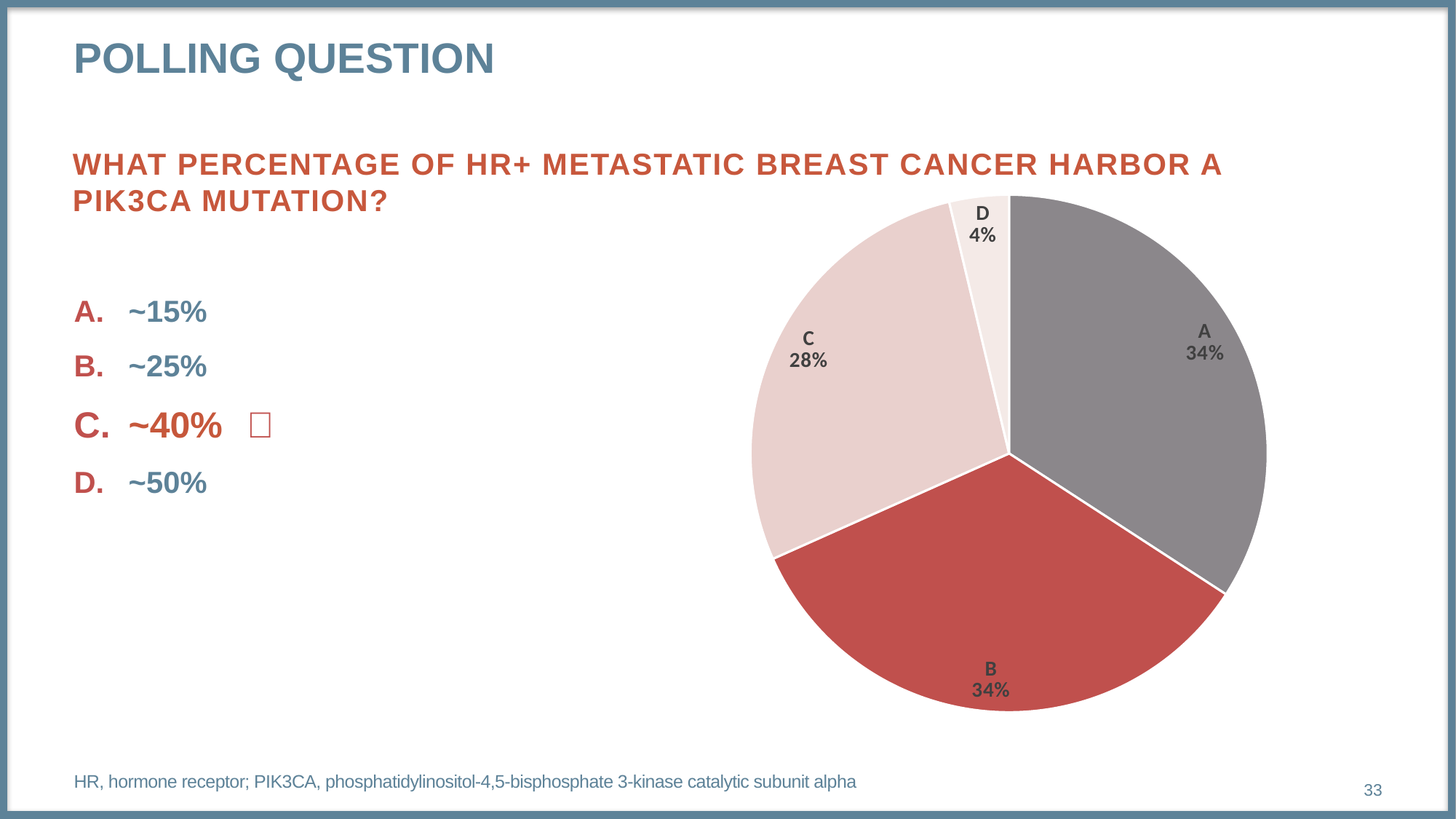
Which is larger, slice B or slice C? B What kind of chart is shown on the slide? Pie chart How many slices does the pie chart have? 4 What percentage is shown for slice D? 4% What percentage is shown for slice A? 34% What percentage of the pie is labelled for slice C? 28% What is the difference in percentage points between slice C and slice D? 24 Which slice of the pie is the smallest? D What percentage is shown for slice B? 34% Which is larger, slice C or slice D? C What colour is slice B in the pie chart? Red What is the difference in percentage points between slice A and slice C? 6